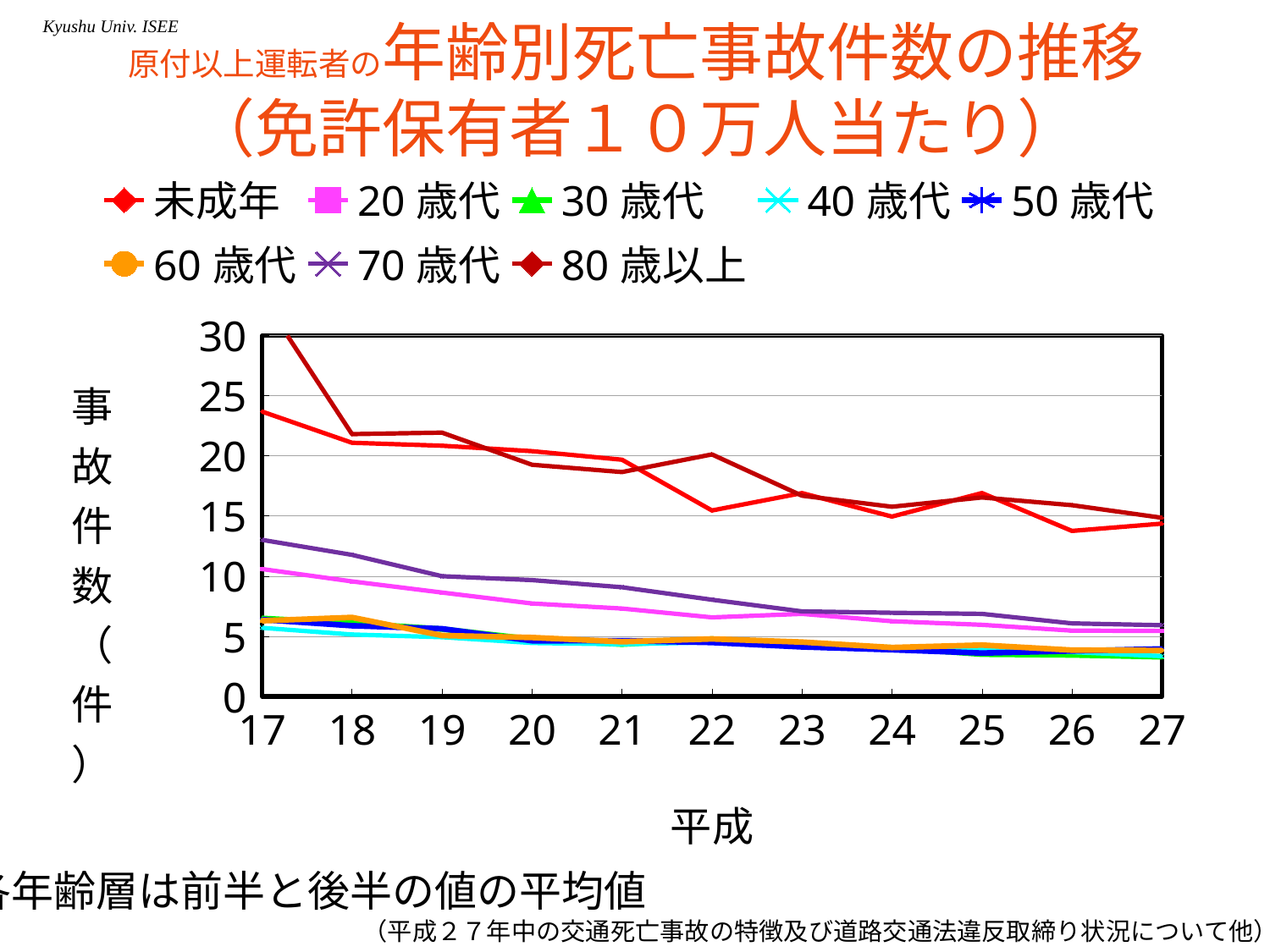
What is the label of the x axis? 平成 Is the value for 未成年 at 平成17 greater or less than 20? greater How many years (points) are plotted along the x axis? 11 What kind of chart is shown on the slide? line chart Is the value for 80歳以上 at 平成21 greater or less than 20? less Which series has the highest value at 平成17? 80歳以上 How many series does the legend list? 8 Is the value for 70歳代 at 平成17 greater or less than 10? greater What is the label of the y axis? 事故件数（件） Does the 70歳代 series rise or fall from 平成17 to 平成27? fall Which is larger at 平成26, 80歳以上 or 未成年? 80歳以上